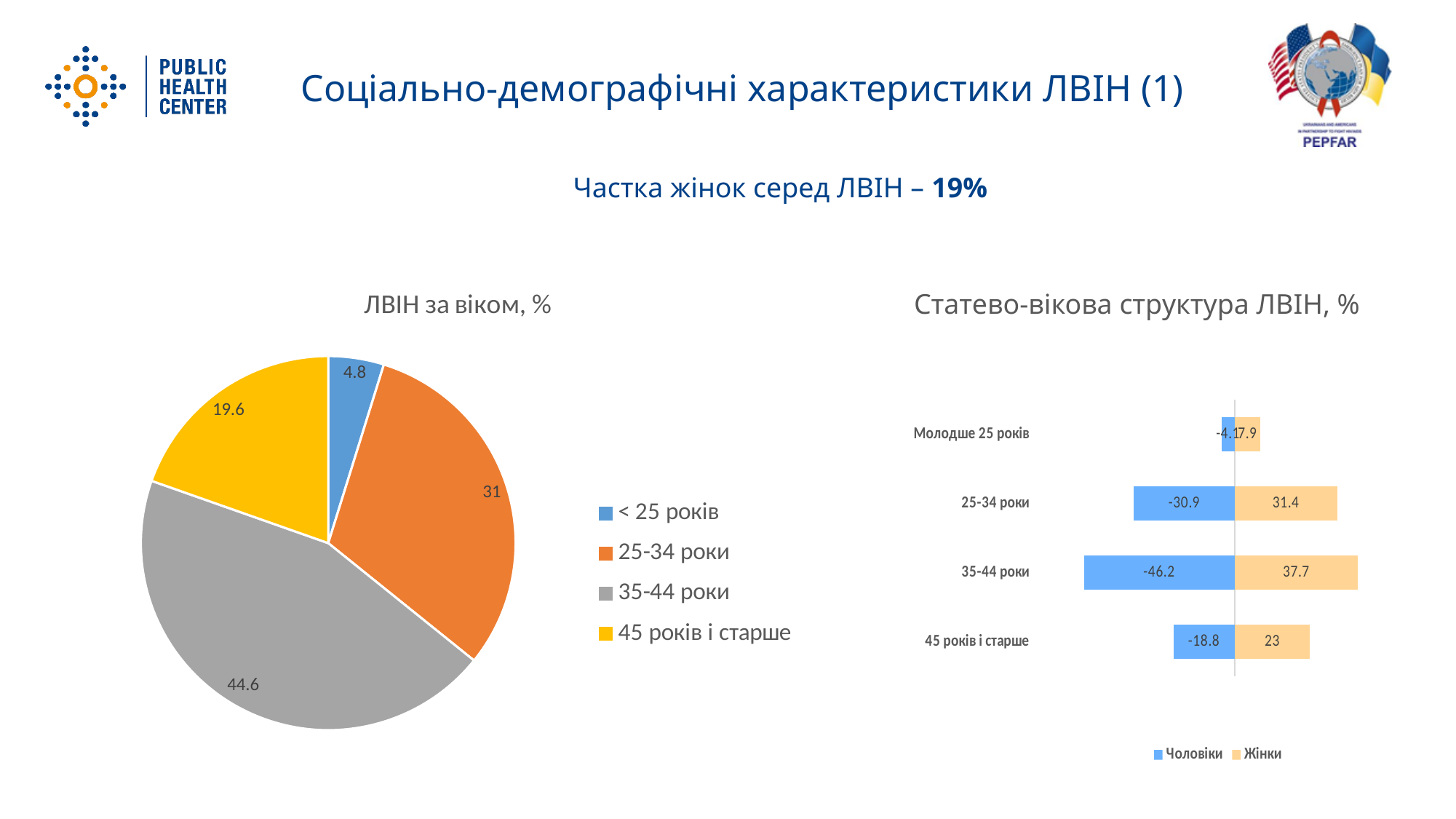
In the pie chart 'ЛВІН за віком, %', what is the value for the '< 25 років' slice? 4.8 What type of chart is 'Статево-вікова структура ЛВІН, %'? Bar chart How many series does the legend of 'Статево-вікова структура ЛВІН, %' list? 2 In the pie chart 'ЛВІН за віком, %', which age group has the largest slice? 35-44 роки In the pie chart 'ЛВІН за віком, %', what is the value for the '35-44 роки' slice? 44.6 What type of chart is 'ЛВІН за віком, %'? Pie chart In the chart 'Статево-вікова структура ЛВІН, %', what is the value for Чоловіки in the '25-34 роки' group? -30.9 In the pie chart 'ЛВІН за віком, %', what is the difference between the '25-34 роки' and '45 років і старше' slices? 11.4 In the chart 'Статево-вікова структура ЛВІН, %', what is the value for Жінки in the '35-44 роки' group? 37.7 In the pie chart 'ЛВІН за віком, %', which age group has the smallest slice? < 25 років In the chart 'Статево-вікова структура ЛВІН, %', which is larger in the '45 років і старше' group: the Жінки value or the absolute Чоловіки value? Жінки In the pie chart 'ЛВІН за віком, %', how many slices are there? 4